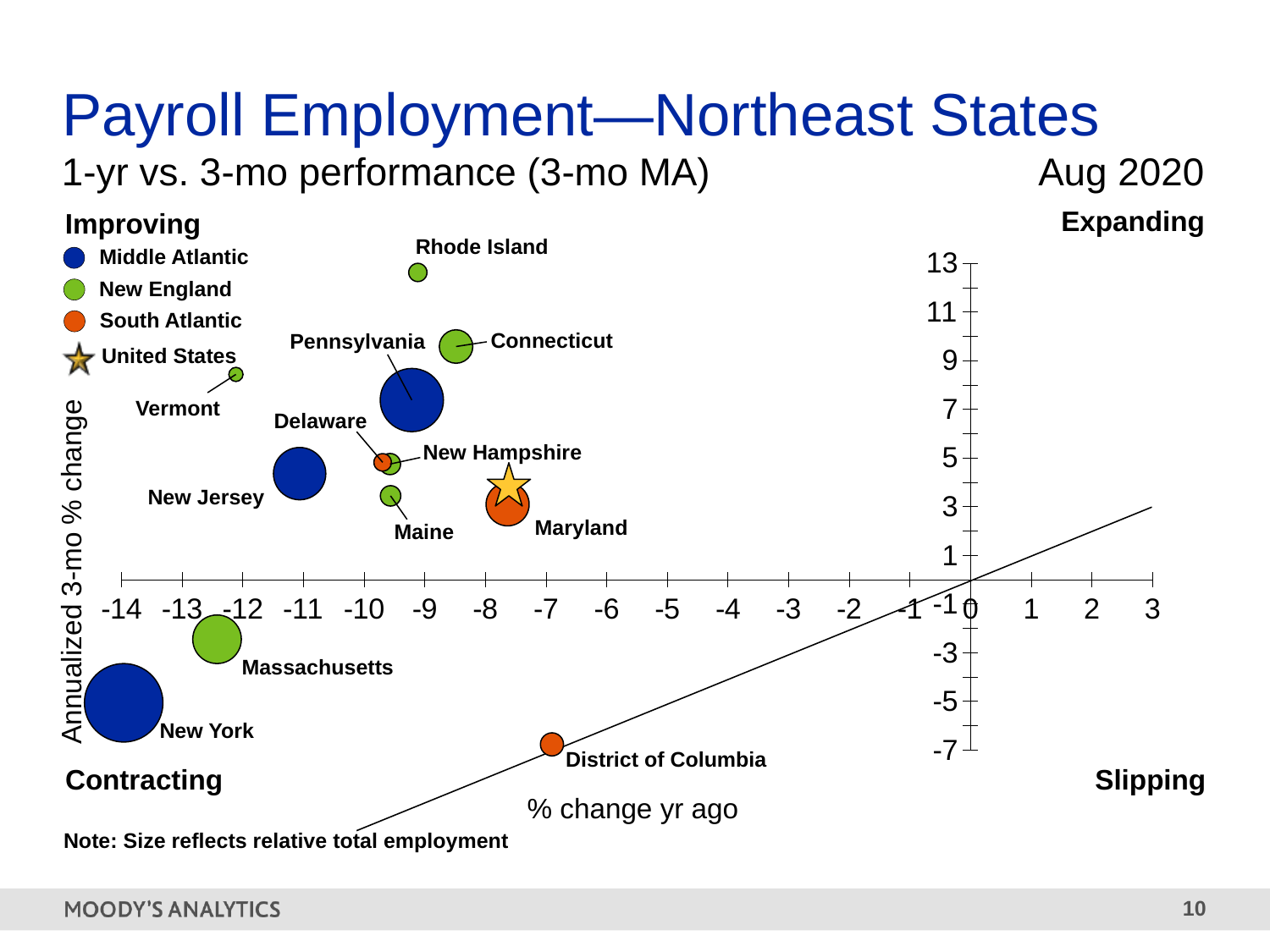
Which has the higher annualized 3-mo % change, Connecticut or Pennsylvania? Connecticut Is the % change from a year ago for New York greater or less than -13? less How many entries does the legend list? 4 What kind of chart is shown on the slide? bubble chart Is the annualized 3-mo % change for New York greater or less than -3? less Is the annualized 3-mo % change for District of Columbia greater or less than -5? less According to the note, what does the size of each bubble reflect? Relative total employment Which state has the lowest % change from a year ago? New York Which labeled point has the lowest annualized 3-mo % change? District of Columbia Which state has the highest annualized 3-mo % change? Rhode Island Which has the higher annualized 3-mo % change, Massachusetts or New York? Massachusetts